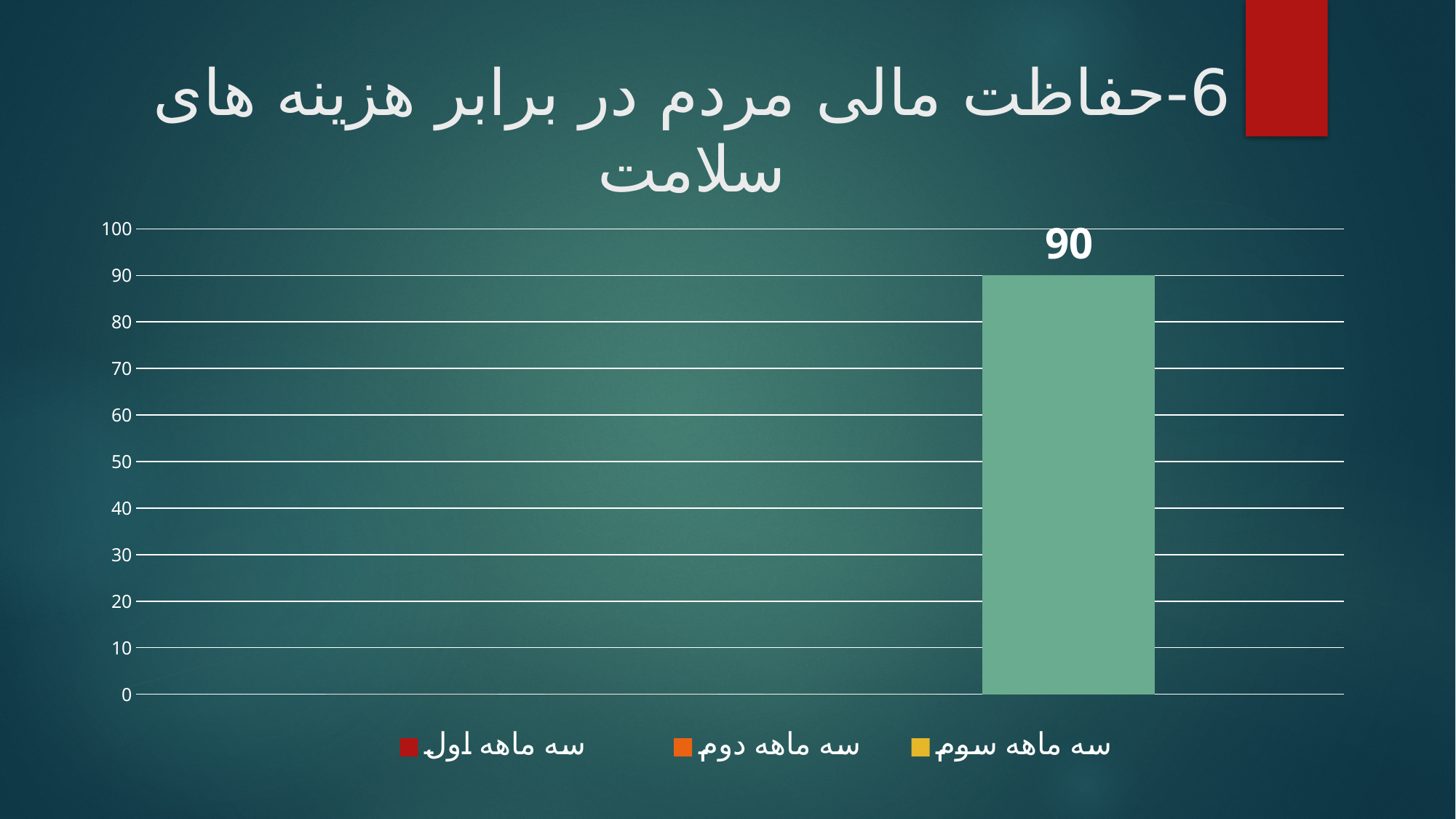
How many series does the legend list? 3 What value is printed on the single bar shown in the chart? 90 Is the value of the bar shown in the chart greater or less than 100? less What is the title of the slide containing the chart? 6-حفاظت مالی مردم در برابر هزینه های سلامت How many bars are plotted in the chart? 1 What is the highest value shown on the vertical axis of the chart? 100 Is the value of the bar shown in the chart greater or less than 80? greater What kind of chart is shown on the slide? bar chart